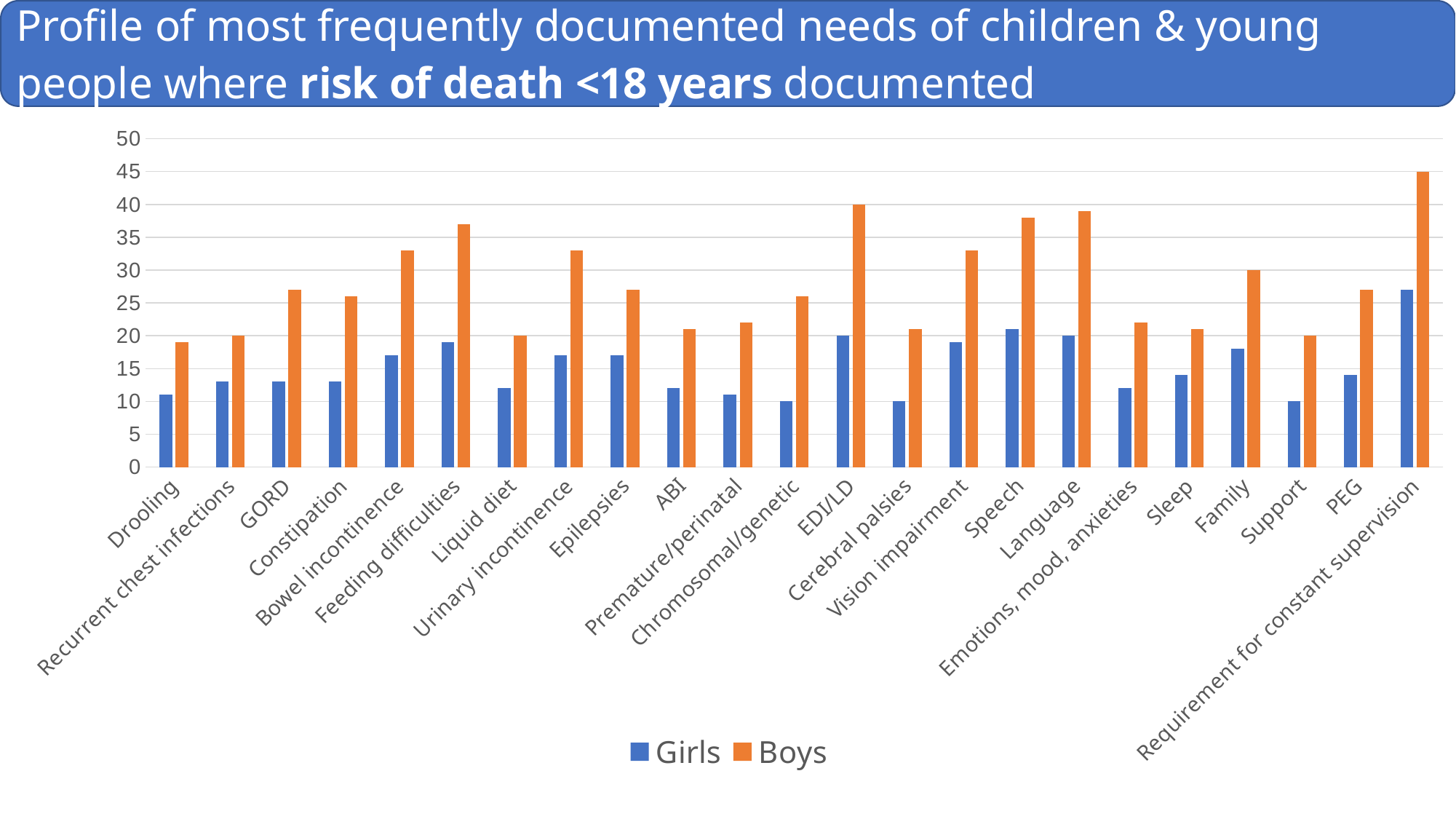
Which category has the highest value for Boys? Requirement for constant supervision How many series does the legend list? 2 What is the value for Boys for EDI/LD? 40 Is the value for Boys for Feeding difficulties greater or less than 35? greater Which is larger for Boys: Feeding difficulties or Bowel incontinence? Feeding difficulties How many categories are shown along the x axis? 23 Which category has the highest value for Girls? Requirement for constant supervision For Speech, which series has the larger value, Girls or Boys? Boys Is the value for Girls for Drooling greater or less than 15? less What kind of chart is shown on the slide? Bar chart What is the value for Boys for Requirement for constant supervision? 45 Which colour represents the Boys series in the legend? Orange